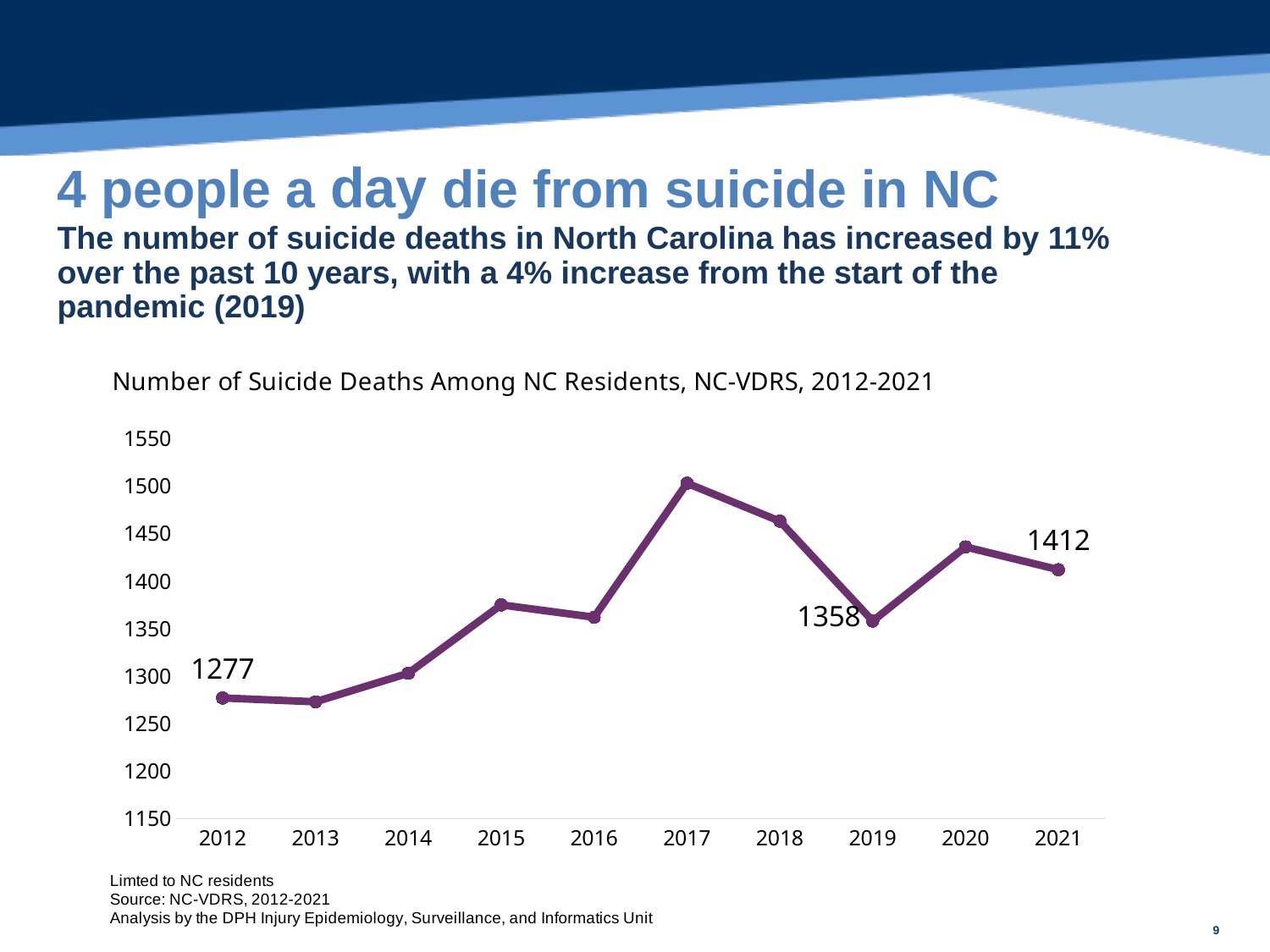
Which year has more suicide deaths, 2017 or 2018? 2017 What is the difference between the number of suicide deaths in 2021 and in 2019? 54 Do the values rise or fall from 2017 to 2019? fall What is the number of suicide deaths in 2021? 1412 Is the value for 2020 greater or less than 1400? greater What kind of chart is shown on the slide? line chart Which year has the highest number of suicide deaths? 2017 How many years are plotted on the chart? 10 Is the value for 2016 greater or less than 1400? less What is the number of suicide deaths in 2019? 1358 What is the number of suicide deaths in 2012? 1277 What is the difference between the number of suicide deaths in 2021 and in 2012? 135